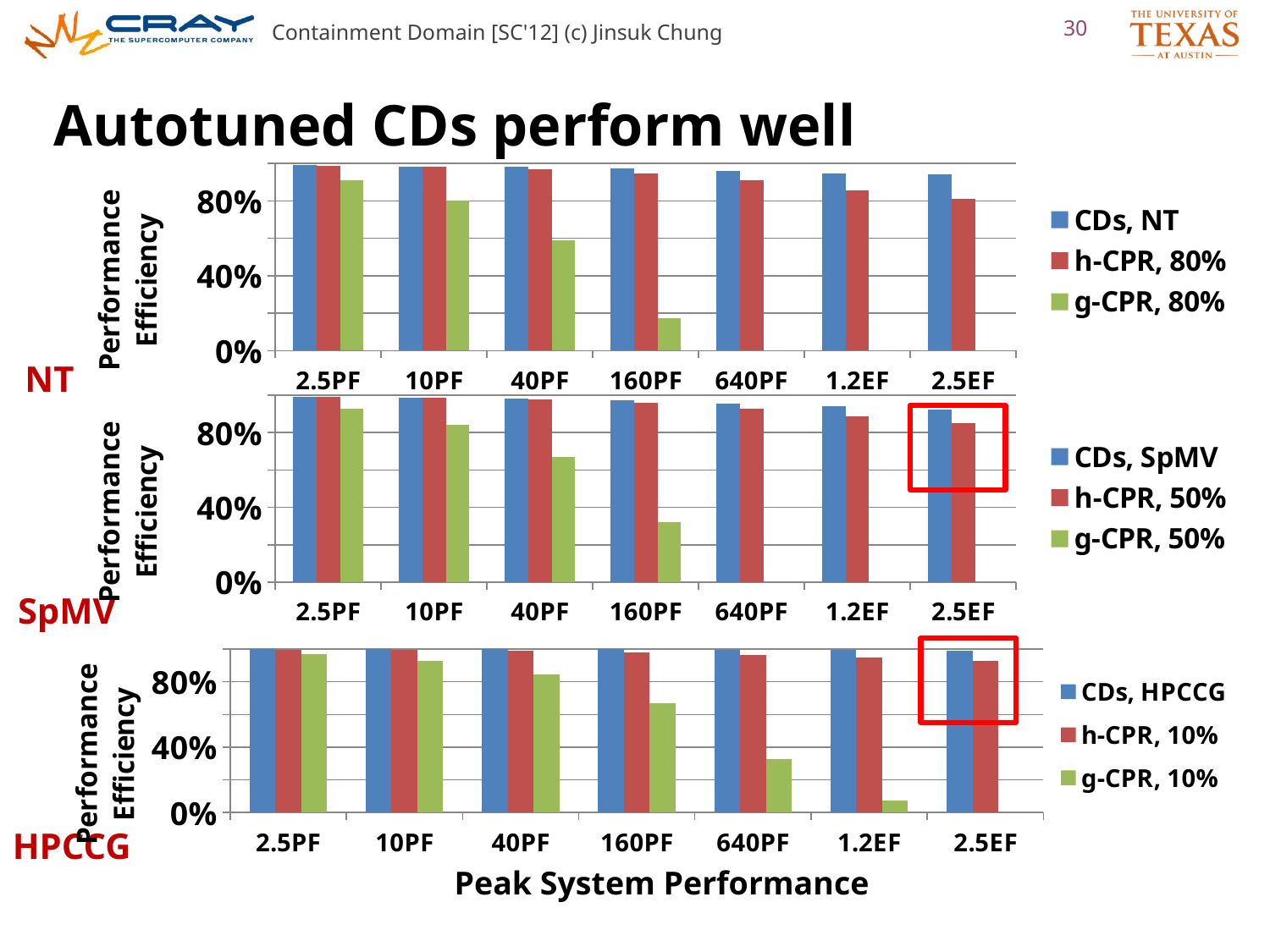
What is the x-axis label shared by the charts on the slide? Peak System Performance In the middle chart (SpMV), does the g-CPR, 50% series rise or fall as peak system performance increases along the x axis? fall In the bottom chart (HPCCG), is the value for h-CPR, 10% at 2.5EF greater or less than 80%? greater What kind of chart is the top chart (NT)? bar chart How many series does the legend of the middle chart (SpMV) list? 3 In the middle chart (SpMV), is the value for g-CPR, 50% at 160PF greater or less than 40%? less In the top chart (NT), which is larger at 2.5EF: CDs, NT or h-CPR, 80%? CDs, NT In the top chart (NT), is the value for g-CPR, 80% at 40PF greater or less than 40%? greater In the top chart (NT), at which category is the g-CPR, 80% value highest? 2.5PF How many categories are shown on the x axis of the bottom chart (HPCCG)? 7